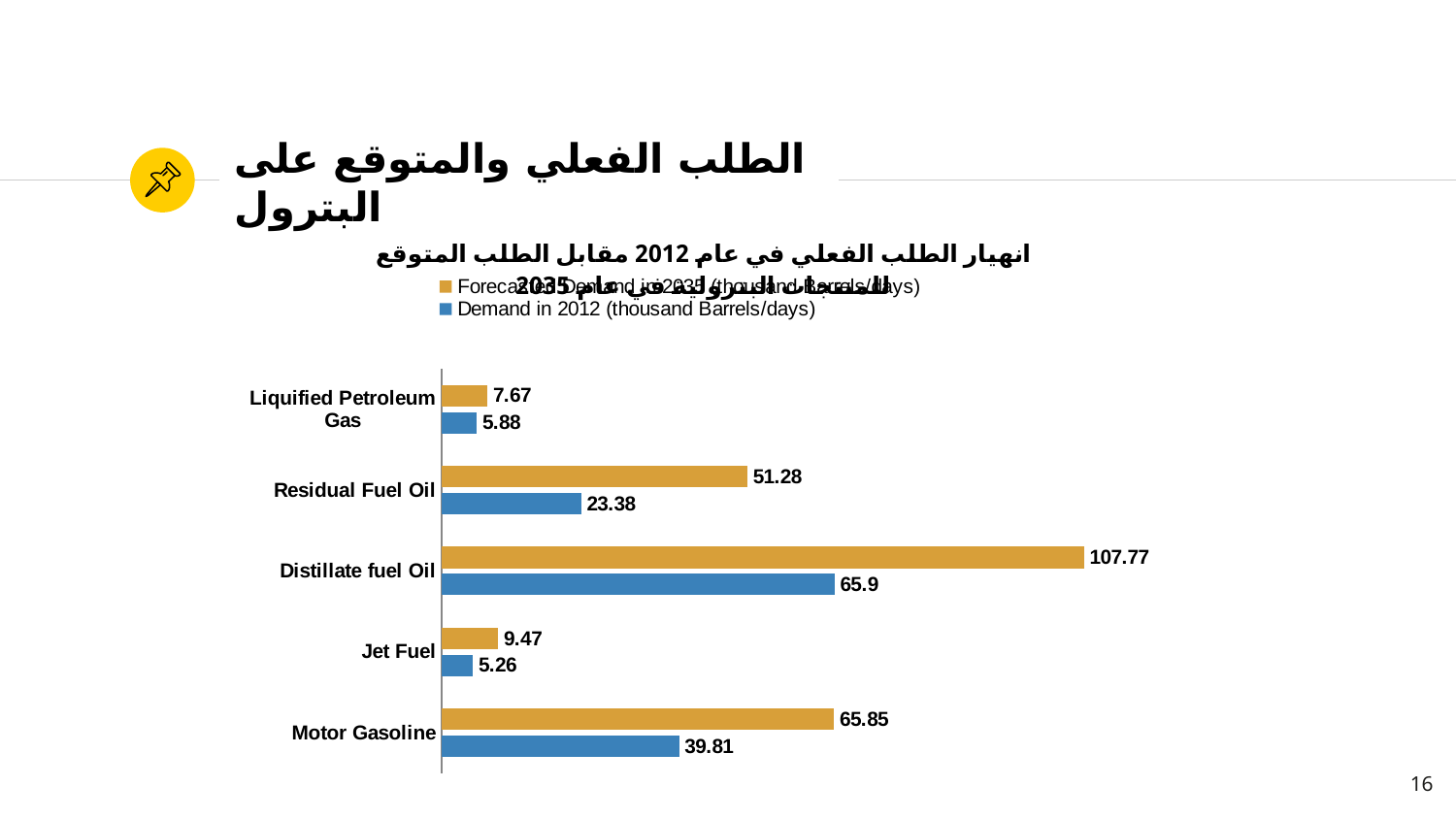
What is the Demand in 2012 value for Motor Gasoline? 39.81 What is the Forecasted Demand in 2035 value for Residual Fuel Oil? 51.28 How many categories are shown on the chart? 5 How many series does the legend list? 2 What type of chart is shown on the slide? Bar chart Which is larger: the Demand in 2012 for Residual Fuel Oil or the Demand in 2012 for Motor Gasoline? Motor Gasoline Which colour represents the Demand in 2012 series? Blue Which category has the lowest Demand in 2012? Jet Fuel What is the Forecasted Demand in 2035 value for Jet Fuel? 9.47 Which category has the highest Forecasted Demand in 2035? Distillate fuel Oil What is the Demand in 2012 value for Distillate fuel Oil? 65.9 What is the difference between the Forecasted Demand in 2035 and the Demand in 2012 for Motor Gasoline? 26.04